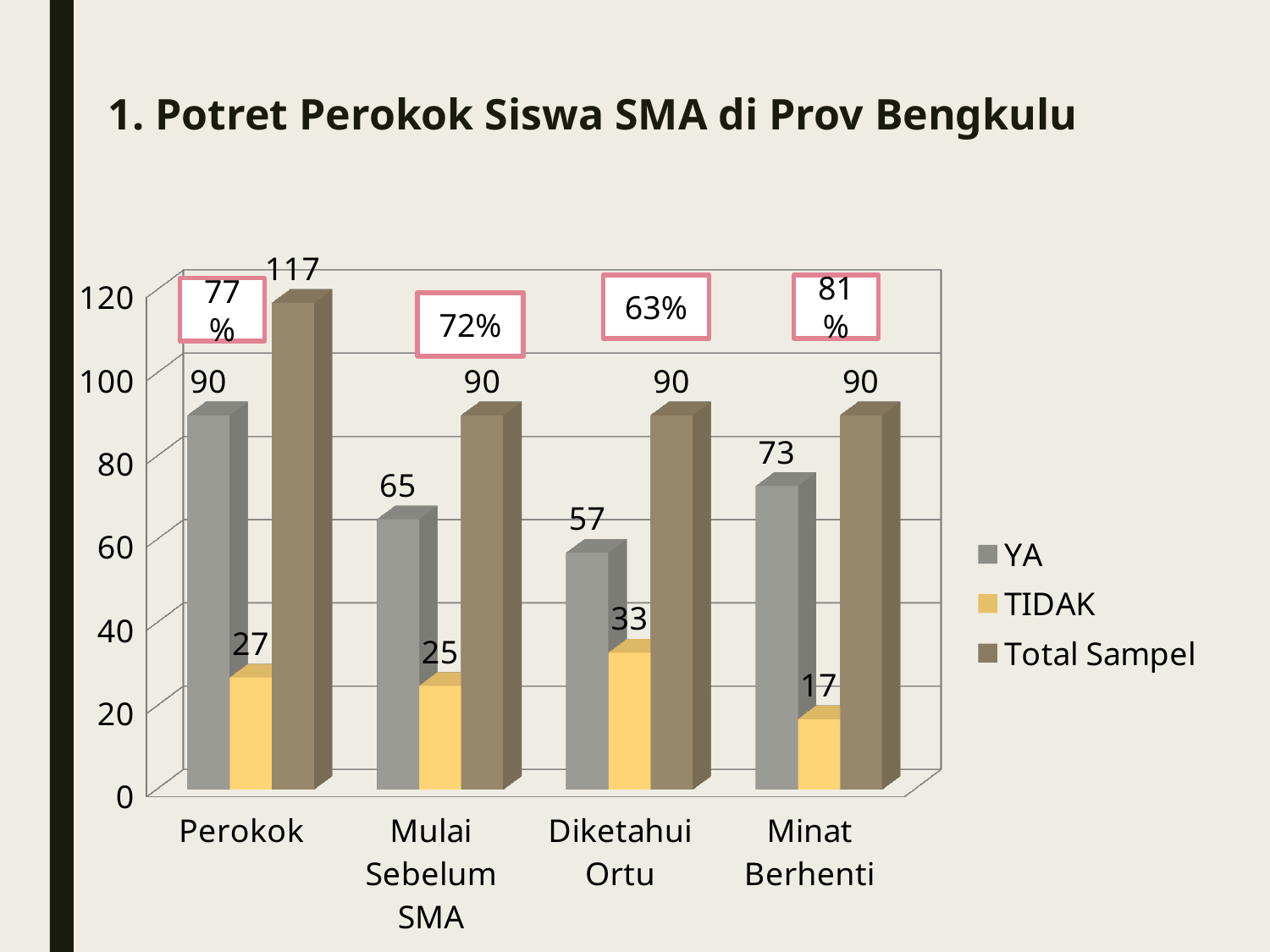
What percentage is shown in the box above the Mulai Sebelum SMA category? 72% How many series does the legend list? 3 Which category has the lowest TIDAK value? Minat Berhenti What is the difference between the YA values for Perokok and Mulai Sebelum SMA? 25 What is the YA value for Minat Berhenti? 73 What is the YA value for Perokok? 90 How many categories are shown on the x axis? 4 What is the TIDAK value for Diketahui Ortu? 33 Which is larger, the YA value for Diketahui Ortu or the YA value for Minat Berhenti? Minat Berhenti What kind of chart is shown on the slide? Bar chart What is the Total Sampel value for Perokok? 117 Which category has the highest Total Sampel value? Perokok